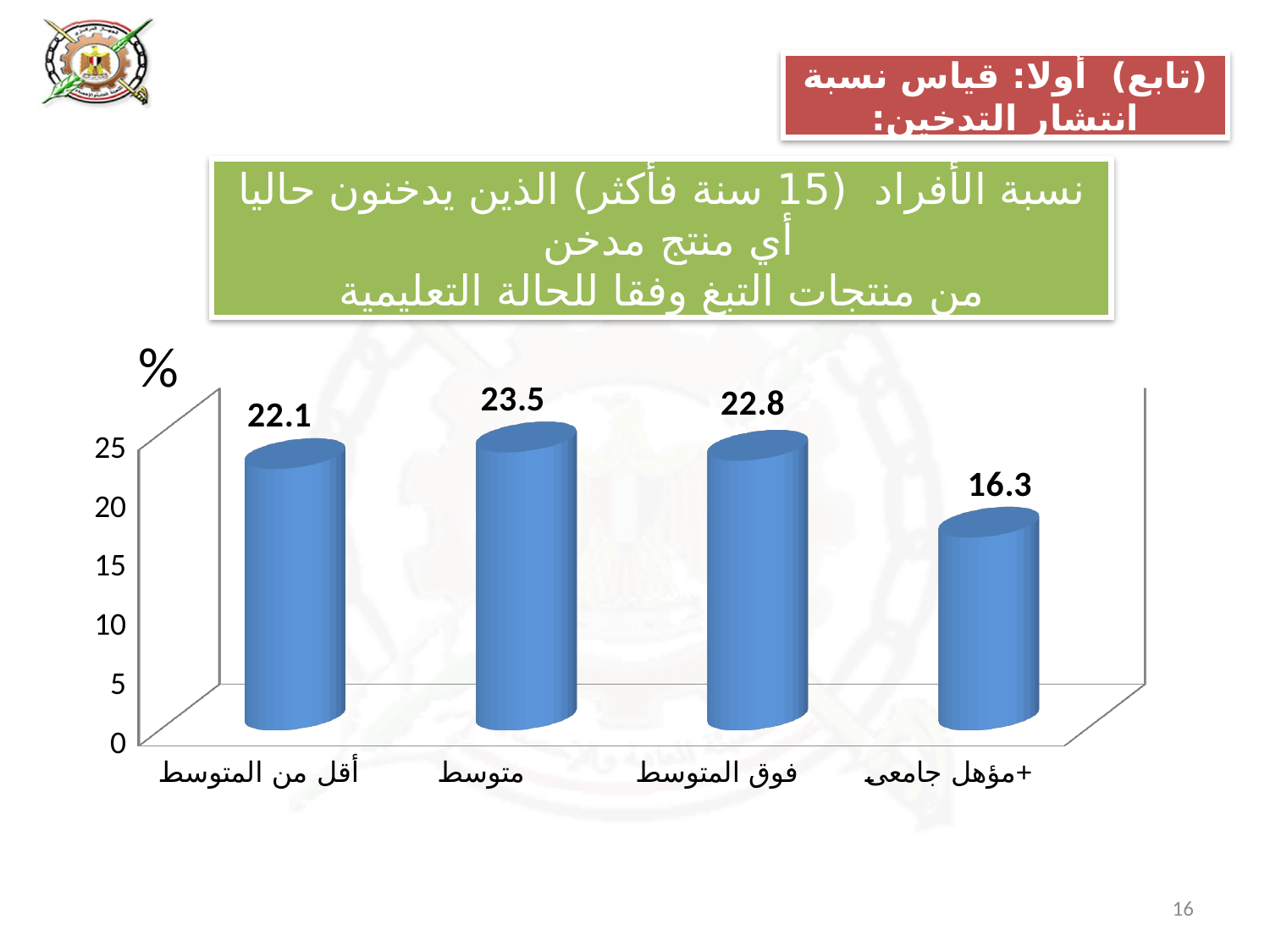
What is the value for the category "متوسط" (average education)? 23.5 What is the value for the category "مؤهل جامعي+" (university qualification and above)? 16.3 What is the value for the category "أقل من المتوسط" (below average education)? 22.1 Which category has the lowest value? مؤهل جامعي+ Which is larger, the value for "أقل من المتوسط" or the value for "مؤهل جامعي+"? أقل من المتوسط What kind of chart is shown on the slide? Bar chart What is the difference between the values for "فوق المتوسط" and "أقل من المتوسط"? 0.7 What is the value for the category "فوق المتوسط" (above average education)? 22.8 What unit symbol is shown at the top of the vertical axis? % How many categories are shown on the x axis? 4 Which category has the highest value? متوسط What is the difference between the values for "متوسط" and "مؤهل جامعي+"? 7.2